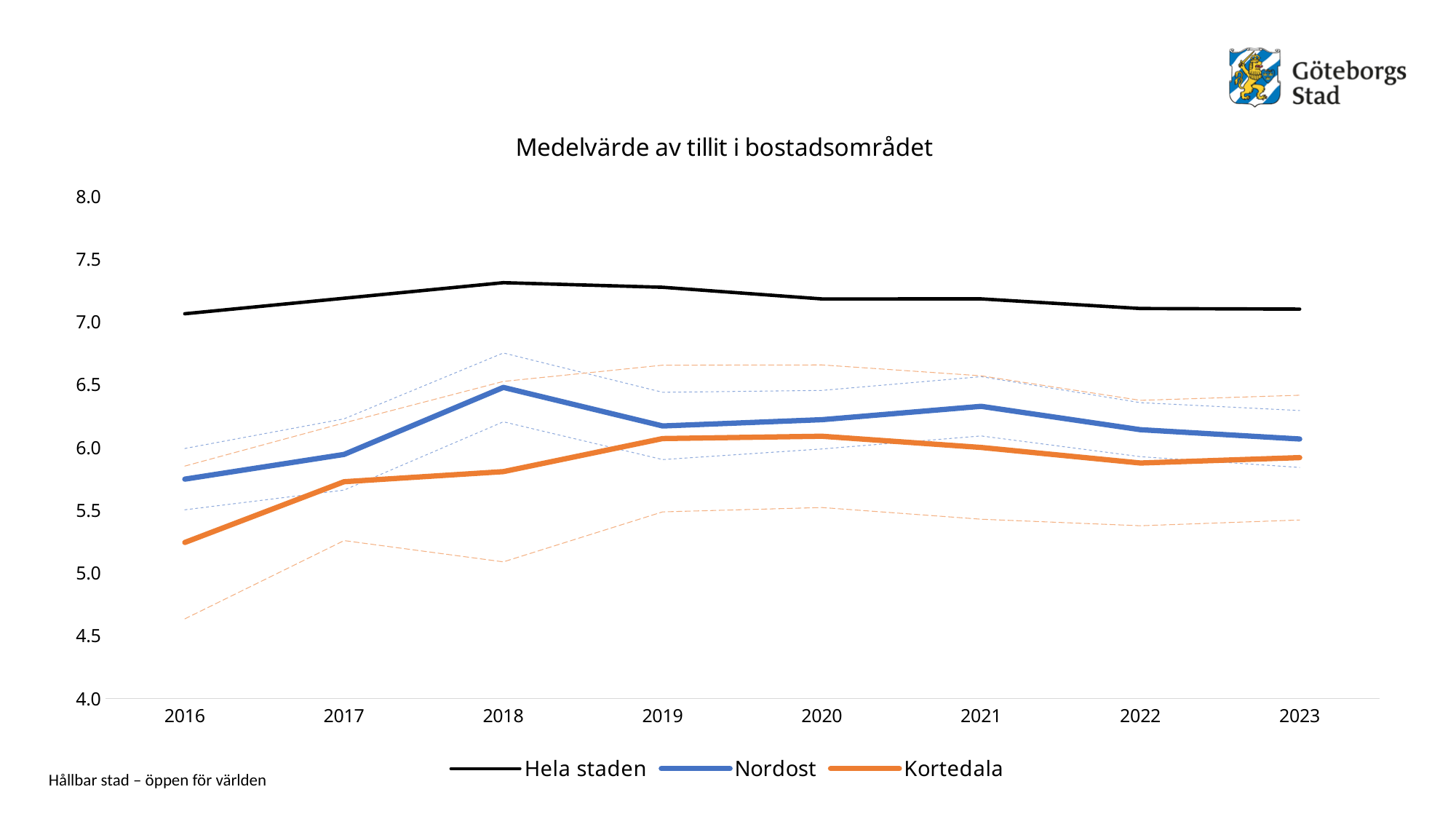
What is the title of the chart? Medelvärde av tillit i bostadsområdet In which year does Nordost reach its highest value? 2018 What kind of chart is shown on the slide? line chart How many series does the legend list? 3 Is the value for Nordost in 2018 greater or less than 6.0? greater Which series has the highest values across all years? Hela staden Is the value for Kortedala in 2016 greater or less than 5.5? less In which year does Kortedala have its lowest value? 2016 In 2018, which is larger: Nordost or Kortedala? Nordost Is the value for Hela staden in 2016 greater or less than 7.0? greater Does the Kortedala line rise or fall from 2016 to 2019? rise How many years are shown on the x axis? 8